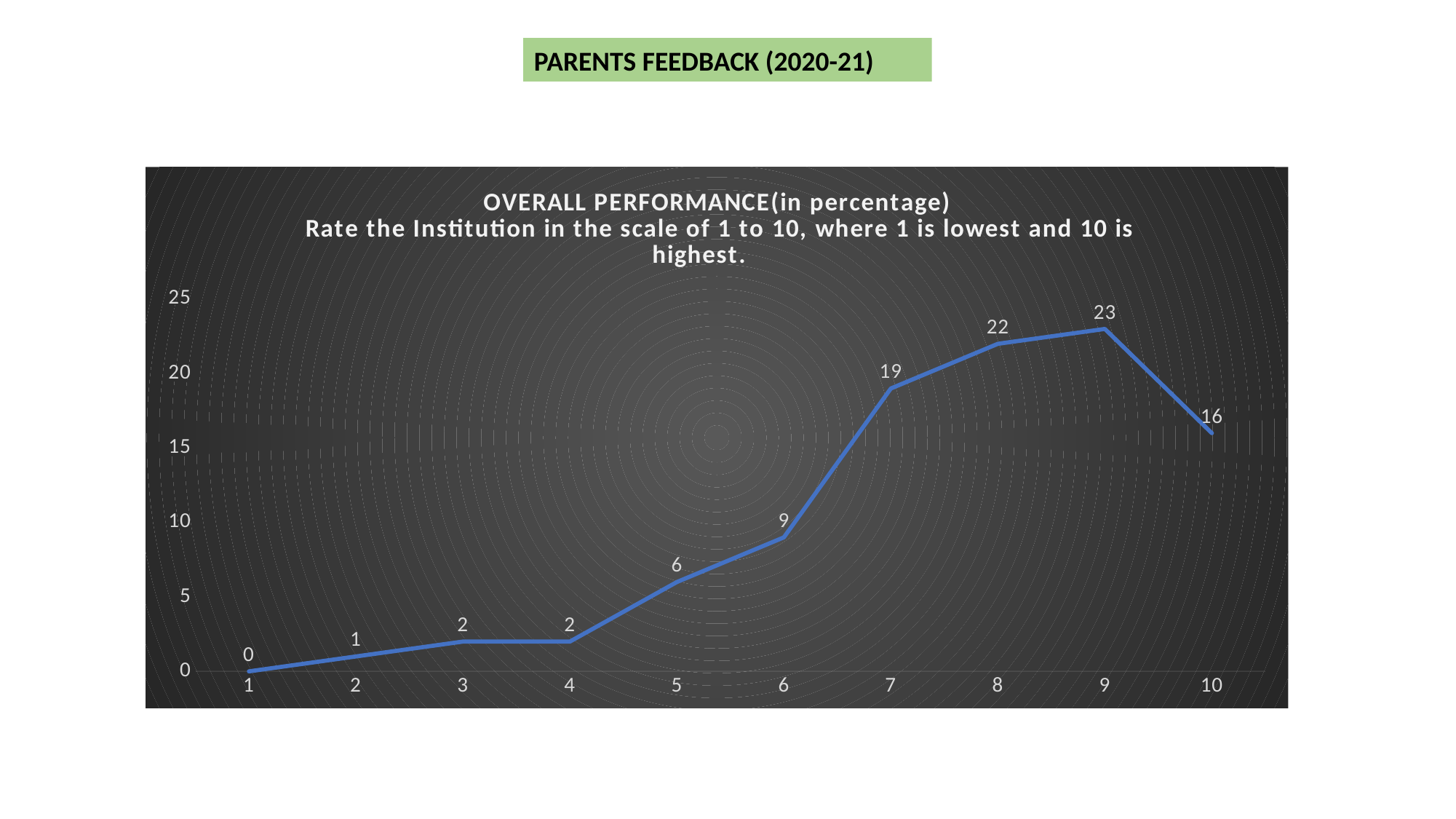
Do the values rise or fall from rating 1 to rating 9? rise What kind of chart is shown on the slide? line chart What is the value for rating 10? 16 What is the value for rating 6? 9 What is the difference between the values for rating 7 and rating 6? 10 Which rating has the lowest value? 1 How many rating points are plotted on the x axis? 10 What is the title of the chart? OVERALL PERFORMANCE(in percentage) Rate the Institution in the scale of 1 to 10, where 1 is lowest and 10 is highest. What is the difference between the values for rating 9 and rating 10? 7 What is the value for rating 9? 23 Which has a larger value, rating 8 or rating 7? rating 8 Which rating has the highest value? 9